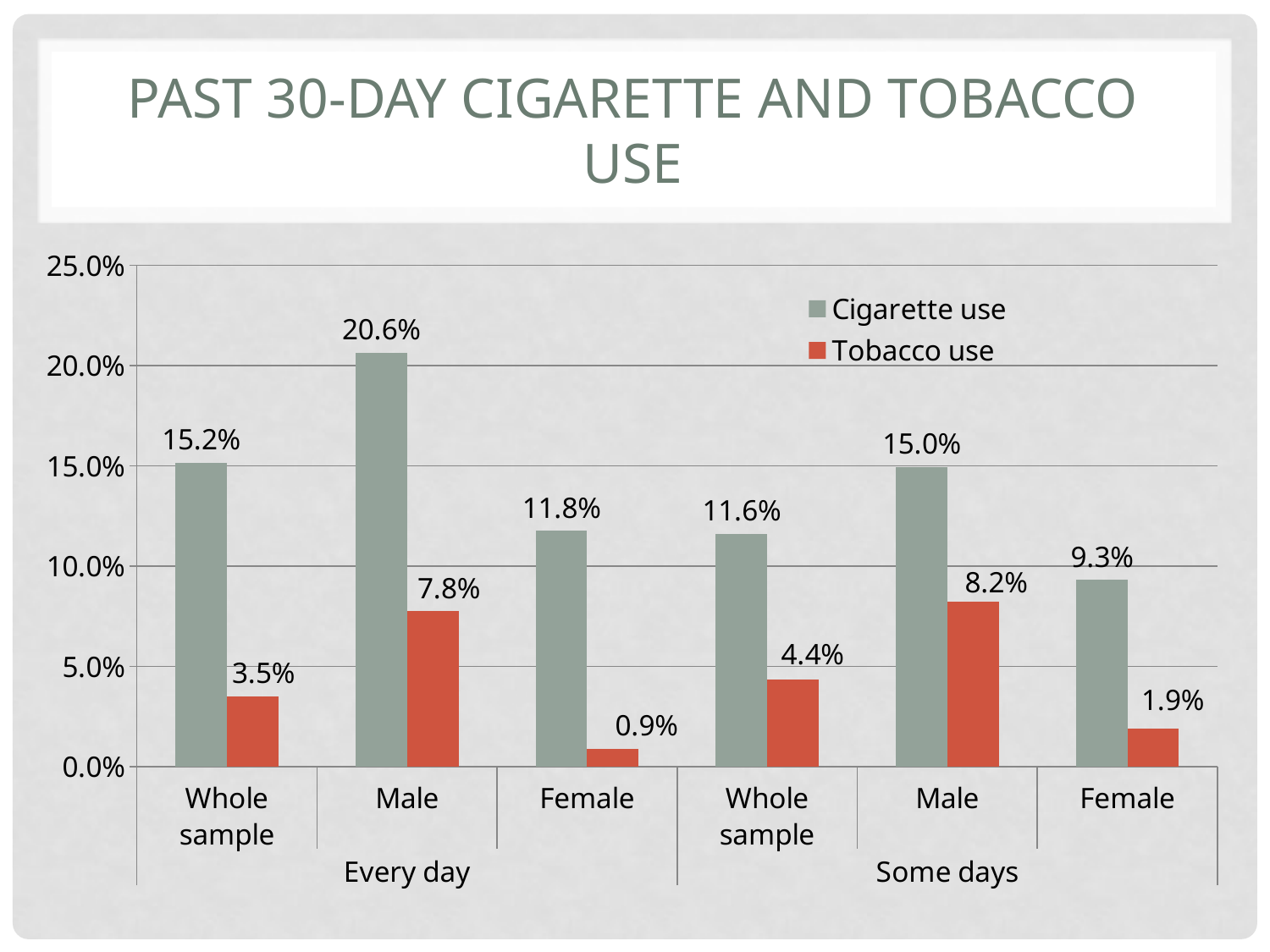
What is the Tobacco use value for Female in the Some days group? 1.9% What is the title of the chart on the slide? Past 30-Day Cigarette and Tobacco Use How many series does the legend list? 2 Which category has the lowest Tobacco use value? Female (Every day) What is the difference in Tobacco use between Male in the Some days group and Male in the Every day group? 0.4% What is the difference between Cigarette use and Tobacco use for Male in the Every day group? 12.8% Which is larger: Cigarette use for Female in the Every day group or Cigarette use for Female in the Some days group? Female in the Every day group What is the Cigarette use value for Whole sample in the Some days group? 11.6% Is the Cigarette use value for Whole sample in the Every day group greater or less than 15.0%? greater What is the Cigarette use value for Male in the Every day group? 20.6% What kind of chart is shown on the slide? Bar chart Which category has the highest Cigarette use value? Male (Every day)